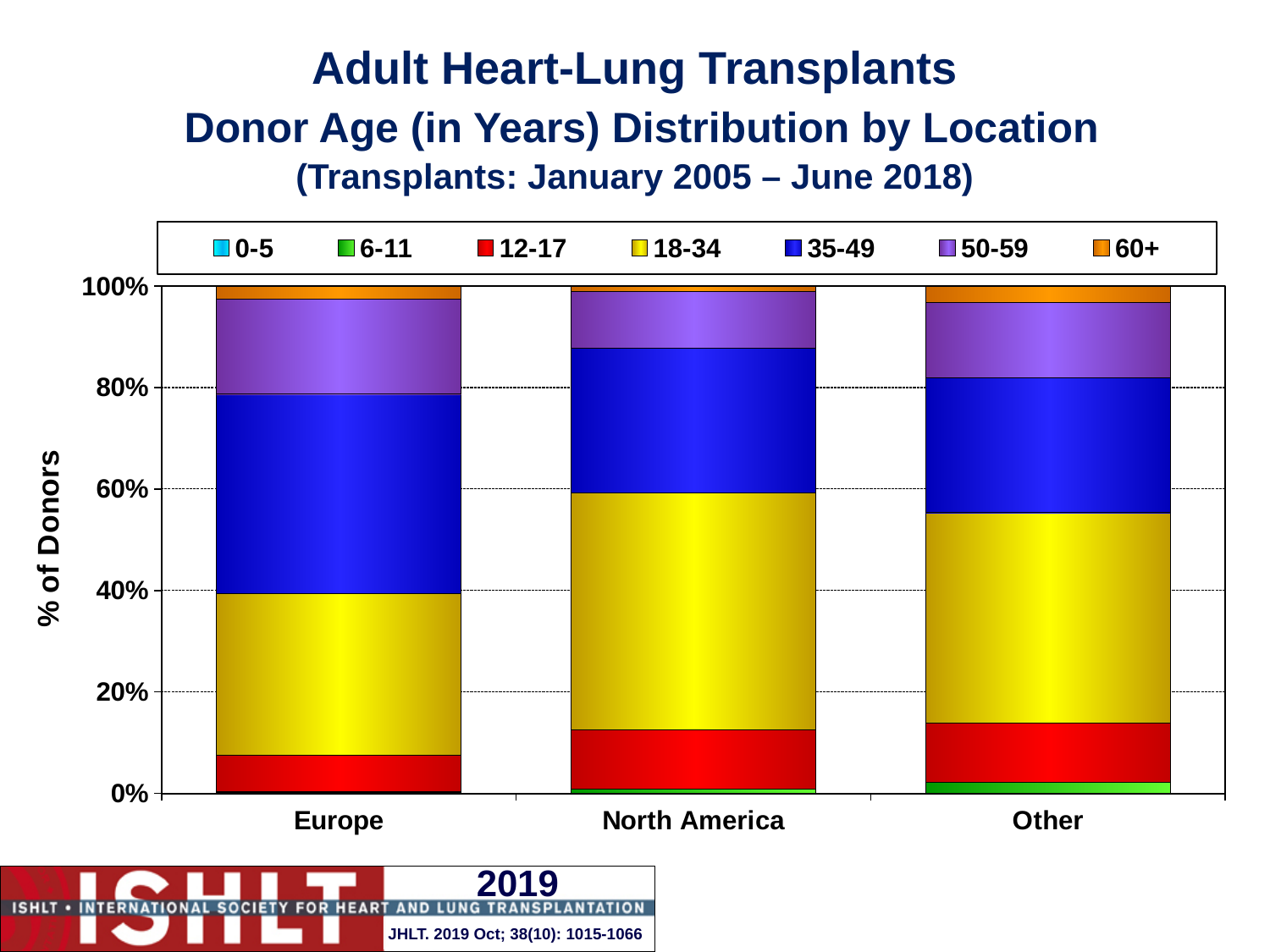
What is the label of the y axis? % of Donors Which location has the largest share of donors aged 50-59? Europe Is the share of donors aged 12-17 in Europe greater or less than 20%? less Is the share of donors aged 18-34 larger in Europe or in North America? North America What kind of chart is shown on the slide? Stacked bar chart Is the share of donors aged 35-49 in North America greater or less than 20%? greater Is the share of donors aged 18-34 in North America greater or less than 40%? greater How many donor age groups does the legend list? 7 How many locations (categories) are shown on the x axis? 3 Which location has the largest share of donors aged 18-34? North America Is the share of donors aged 35-49 larger in Europe or in North America? Europe Which location has the largest share of donors aged 35-49? Europe